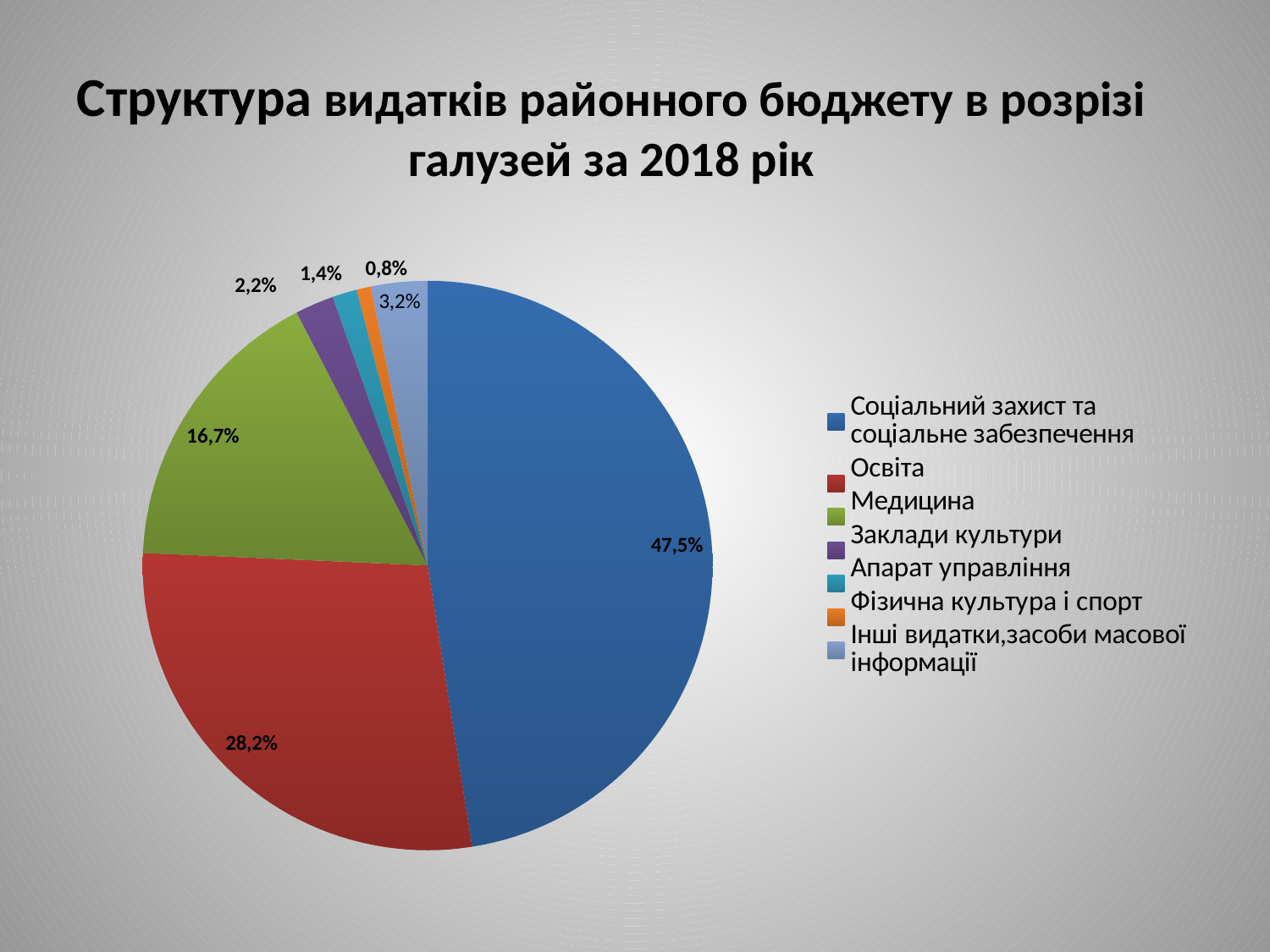
What is the value for Заклади культури? 2,2% What type of chart is shown on the slide? Pie chart How many categories does the legend list? 7 Which category has the smallest share of the pie? Фізична культура і спорт What percentage is shown for Медицина? 16,7% What share is shown for Інші видатки,засоби масової інформації? 3,2% What is the value shown for Освіта? 28,2% What share of the district budget expenditures goes to Соціальний захист та соціальне забезпечення? 47,5% Which category has the largest share of the pie? Соціальний захист та соціальне забезпечення What is the difference between the shares of Освіта and Медицина? 11,5% What is the title of the chart on the slide? Структура видатків районного бюджету в розрізі галузей за 2018 рік Which is larger, the share for Апарат управління or the share for Заклади культури? Заклади культури